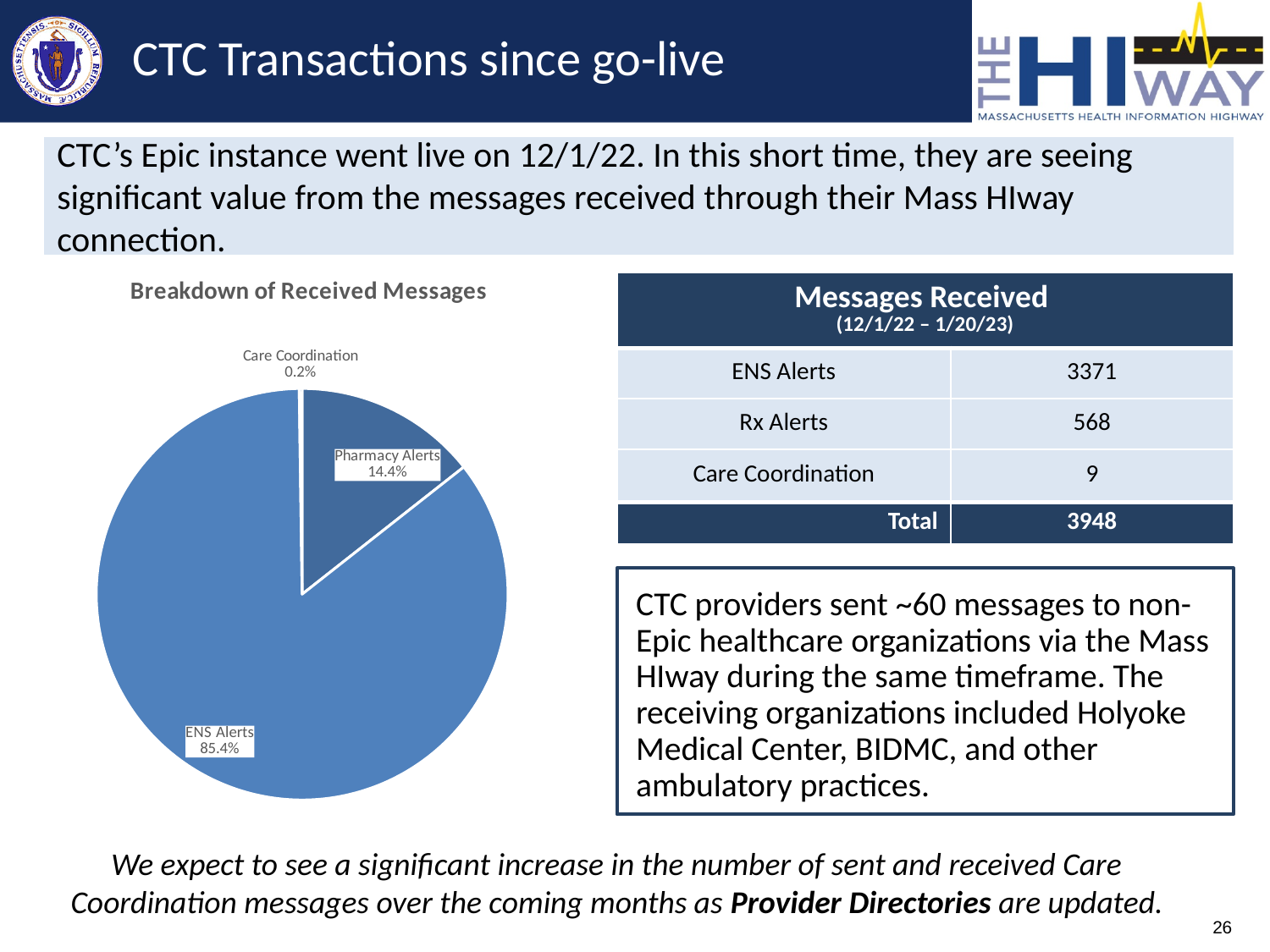
What is the difference in percentage points between the ENS Alerts share and the Pharmacy Alerts share? 71.0% What share of the pie does Care Coordination represent? 0.2% Is the share for ENS Alerts greater or less than 50%? greater Which is larger in the pie chart, Pharmacy Alerts or Care Coordination? Pharmacy Alerts Which slice of the pie chart is the largest? ENS Alerts What share of the pie does ENS Alerts represent? 85.4% What kind of chart is shown on the slide? pie chart What is the difference in percentage points between the Pharmacy Alerts share and the Care Coordination share? 14.2% What share of the pie does Pharmacy Alerts represent? 14.4% How many slices does the pie chart have? 3 What is the title of the chart on the slide? Breakdown of Received Messages Which slice of the pie chart is the smallest? Care Coordination